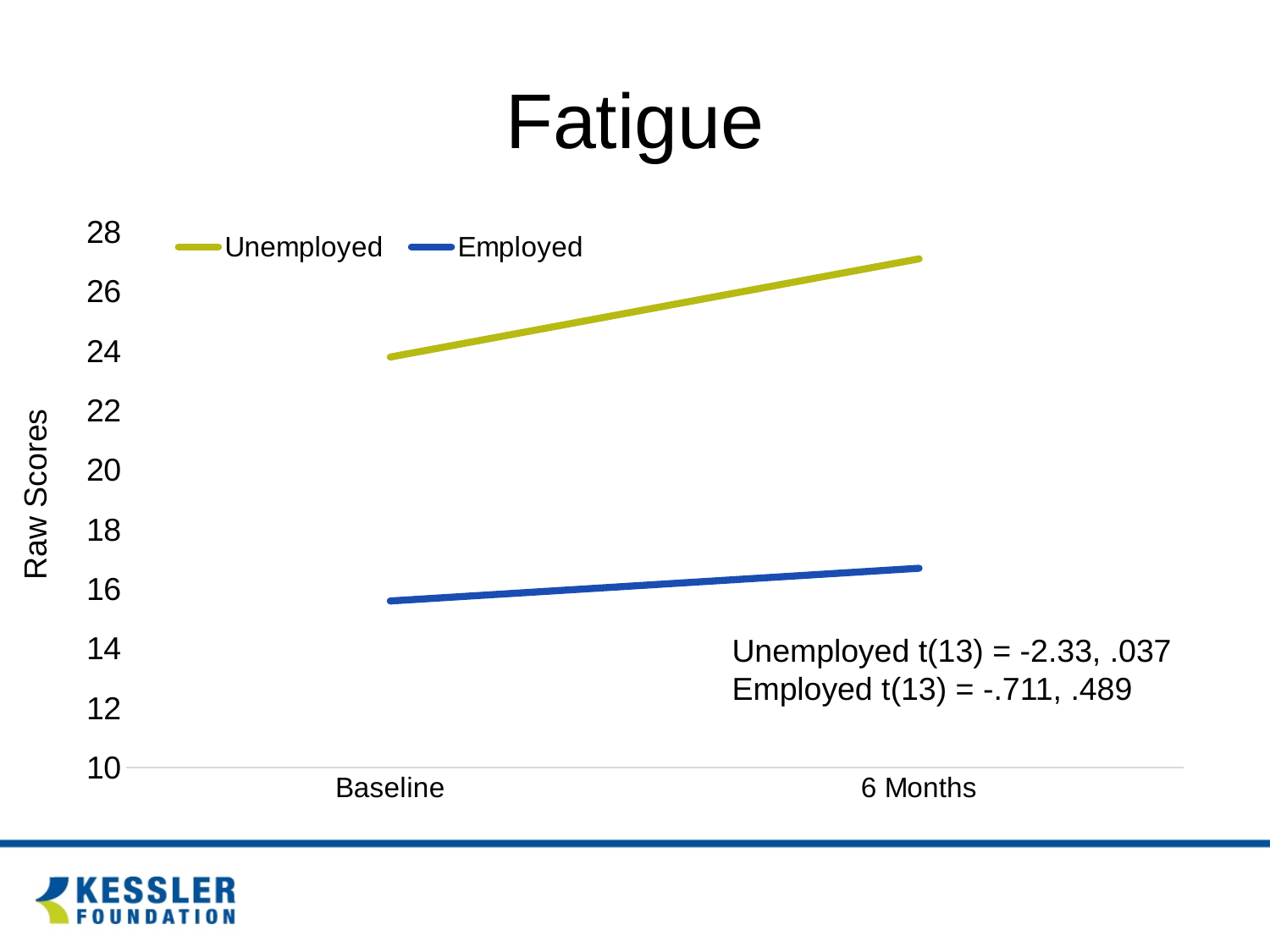
What is the label on the y axis? Raw Scores How many series does the legend list? 2 Is the value for Unemployed at Baseline greater or less than 22? greater Does the Unemployed line rise or fall from Baseline to 6 Months? Rises How many time points are shown on the x axis? 2 Does the Employed line rise or fall from Baseline to 6 Months? Rises What is the title of the chart? Fatigue At 6 Months, which series has the higher raw score, Unemployed or Employed? Unemployed Is the value for Unemployed at 6 Months greater or less than 26? greater What kind of chart is shown on the slide? Line chart Is the value for Employed at 6 Months greater or less than 18? less At Baseline, which series has the higher raw score, Unemployed or Employed? Unemployed